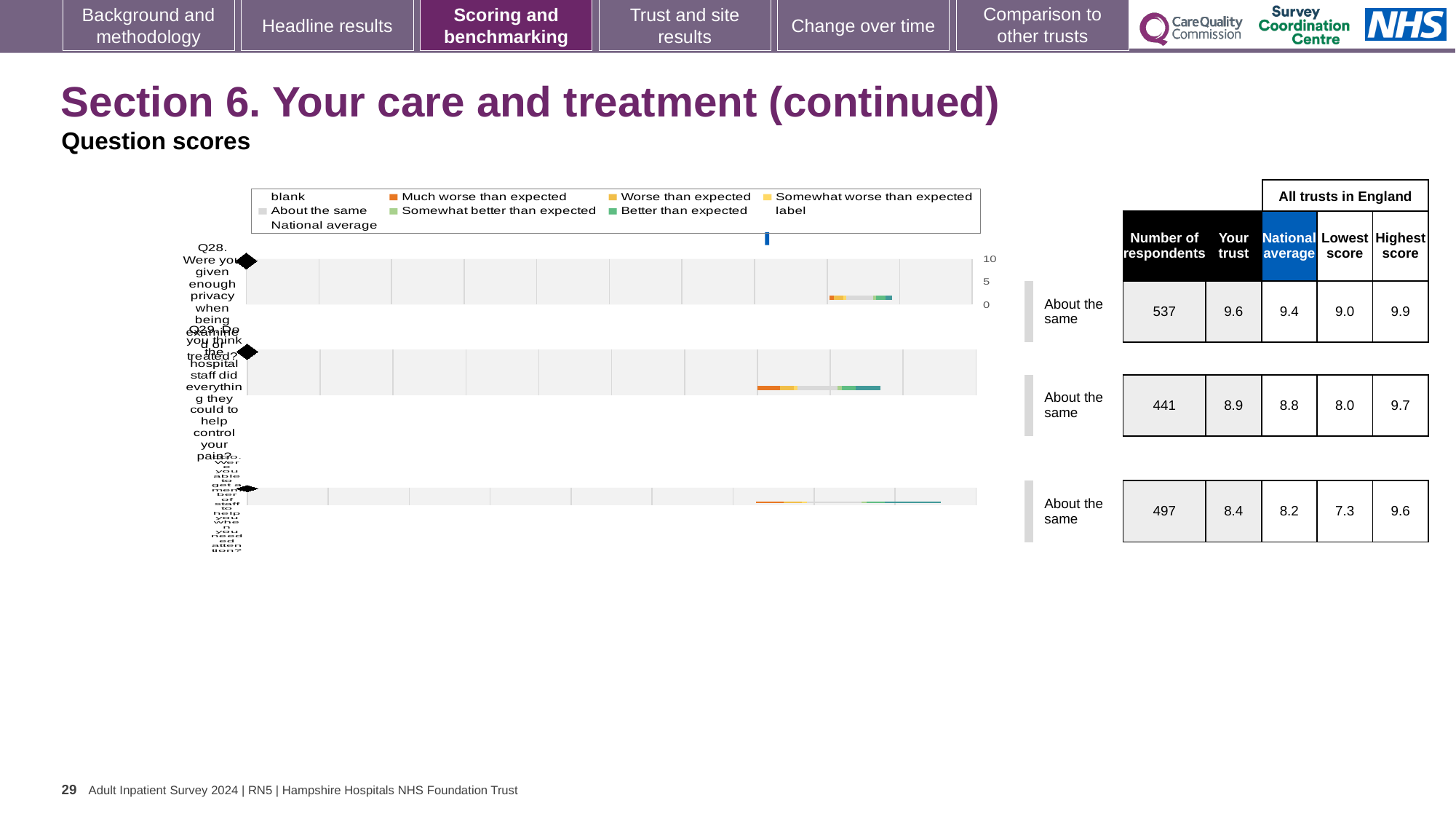
For Q28, which is larger: the 'Your trust' score or the national average? Your trust How many respondents answered Q28 (Were you given enough privacy when being examined or treated?)? 537 What is the highest score among all trusts in England for Q28? 9.9 What is the difference between the 'Your trust' score and the national average for Q30? 0.2 What kind of chart is shown on the slide? Bar chart Which question has the highest 'Your trust' score? Q28 How many questions are plotted on the chart? 3 Which question has the lowest number of respondents? Q29 What benchmark category is shown for Q29? About the same What is the lowest score among all trusts in England for Q30? 7.3 What is the 'Your trust' score for Q29 (Do you think the hospital staff did everything they could to help control your pain?)? 8.9 What is the national average score for Q30 (Were you able to get a member of staff to help you when you needed attention?)? 8.2